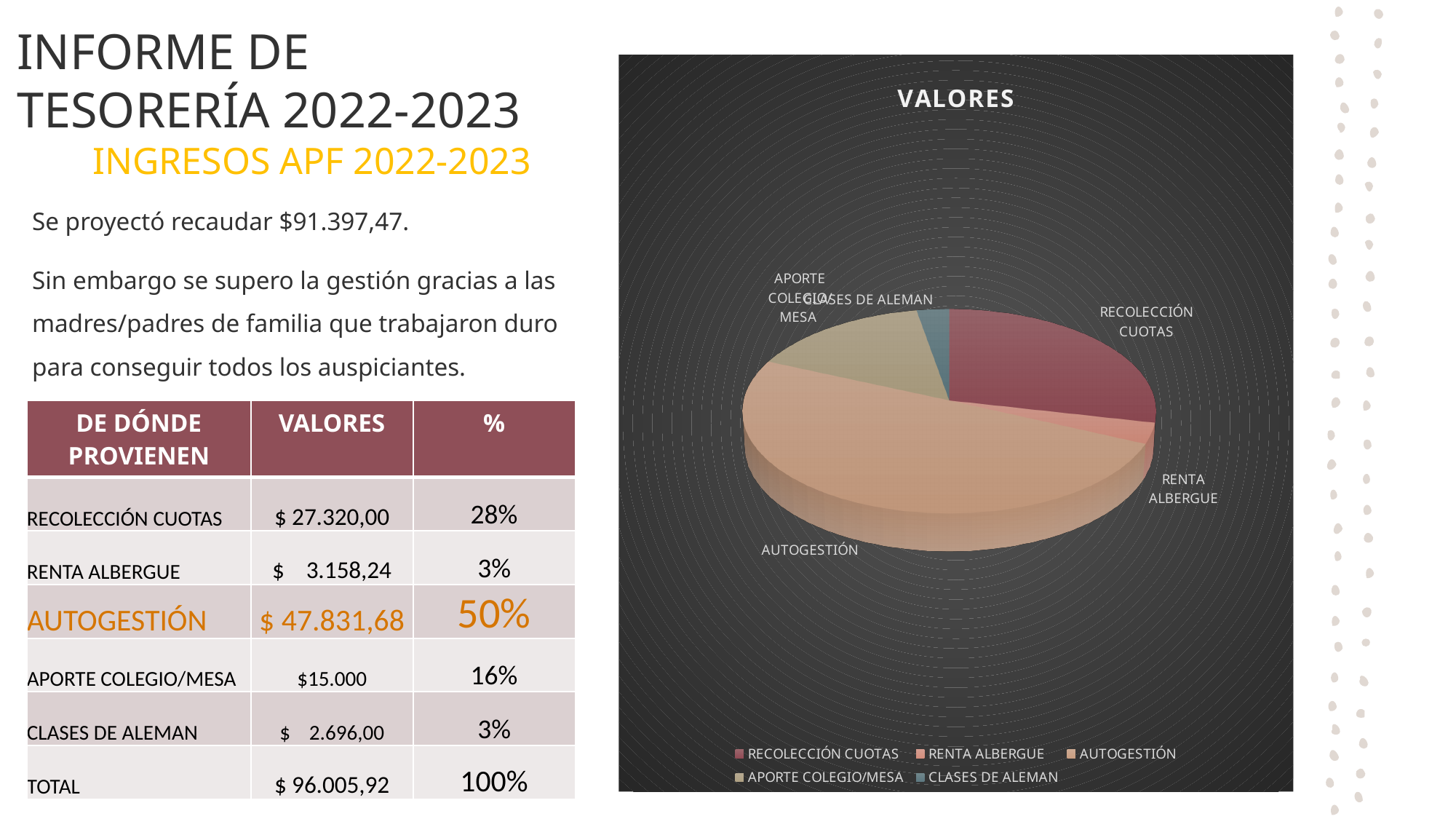
According to the table on the slide, what is the value for RECOLECCIÓN CUOTAS? $ 27.320,00 Which slice is larger in the pie chart, RECOLECCIÓN CUOTAS or APORTE COLEGIO/MESA? RECOLECCIÓN CUOTAS What kind of chart is shown on the slide? pie chart How many entries does the legend of the pie chart list? 5 According to the table on the slide, what is the total of all the values plotted in the pie chart? $ 96.005,92 Using the percentages in the table, how many percentage points larger is the AUTOGESTIÓN share than the RECOLECCIÓN CUOTAS share? 22% Which slice is larger in the pie chart, AUTOGESTIÓN or RECOLECCIÓN CUOTAS? AUTOGESTIÓN According to the table on the slide, what share of the pie does AUTOGESTIÓN represent? 50% What is the title of the pie chart? VALORES According to the table on the slide, what share of the pie does RECOLECCIÓN CUOTAS represent? 28% How many slices does the pie chart have? 5 Which category has the largest slice in the pie chart? AUTOGESTIÓN